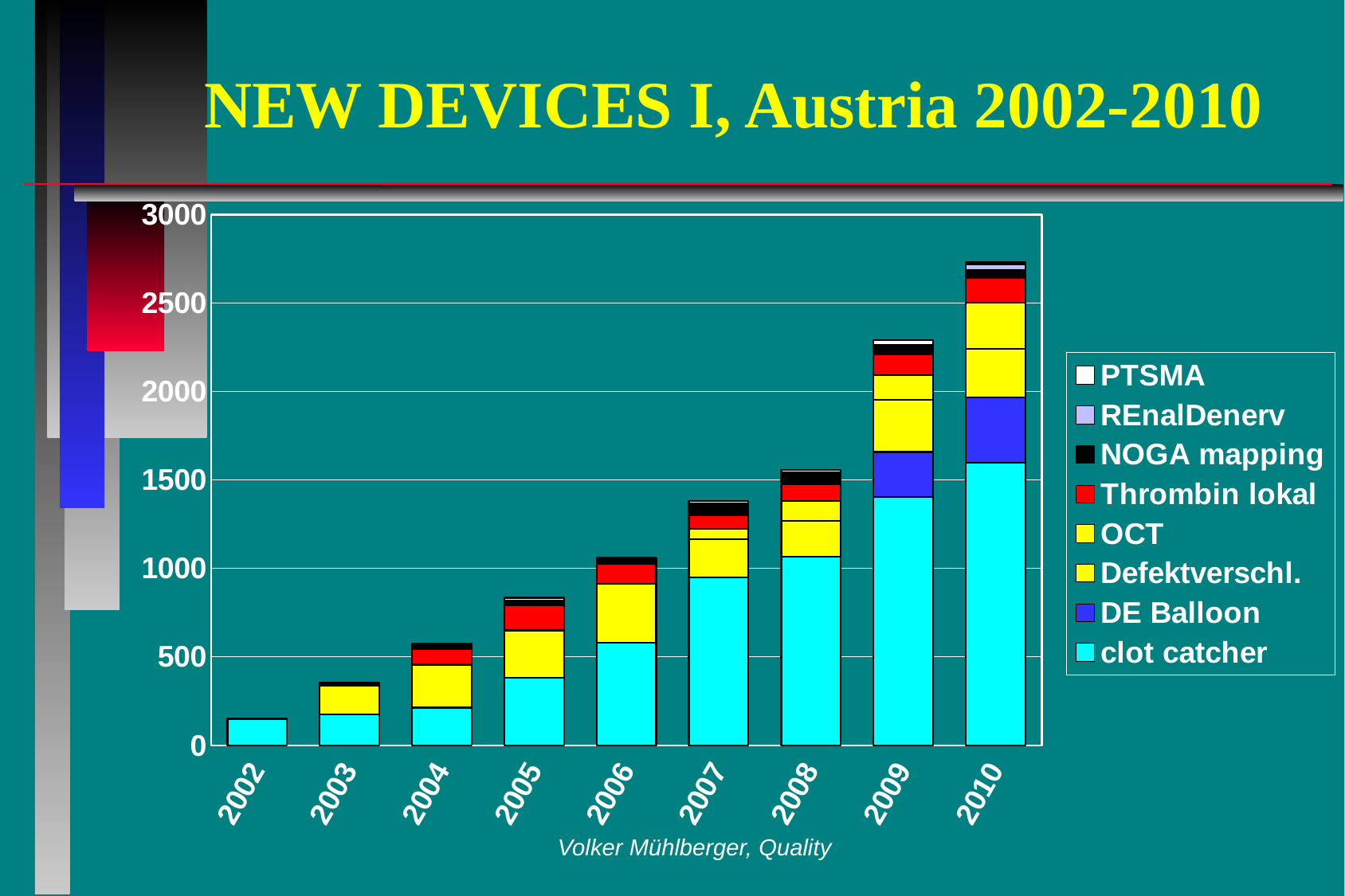
Which year has the taller stacked bar, 2008 or 2009? 2009 How many series does the chart's legend list? 8 Which year has the tallest stacked bar? 2010 Is the total bar height for 2009 greater or less than 2000? greater What is the title of the chart on the slide? NEW DEVICES I, Austria 2002-2010 Is the total bar height for 2005 greater or less than 1000? less Is the total bar height for 2002 greater or less than 500? less How many years are shown along the x axis of the chart? 9 What kind of chart is shown on the slide? stacked bar chart Do the total bar heights rise or fall from 2002 to 2010? rise Which year has the shortest stacked bar? 2002